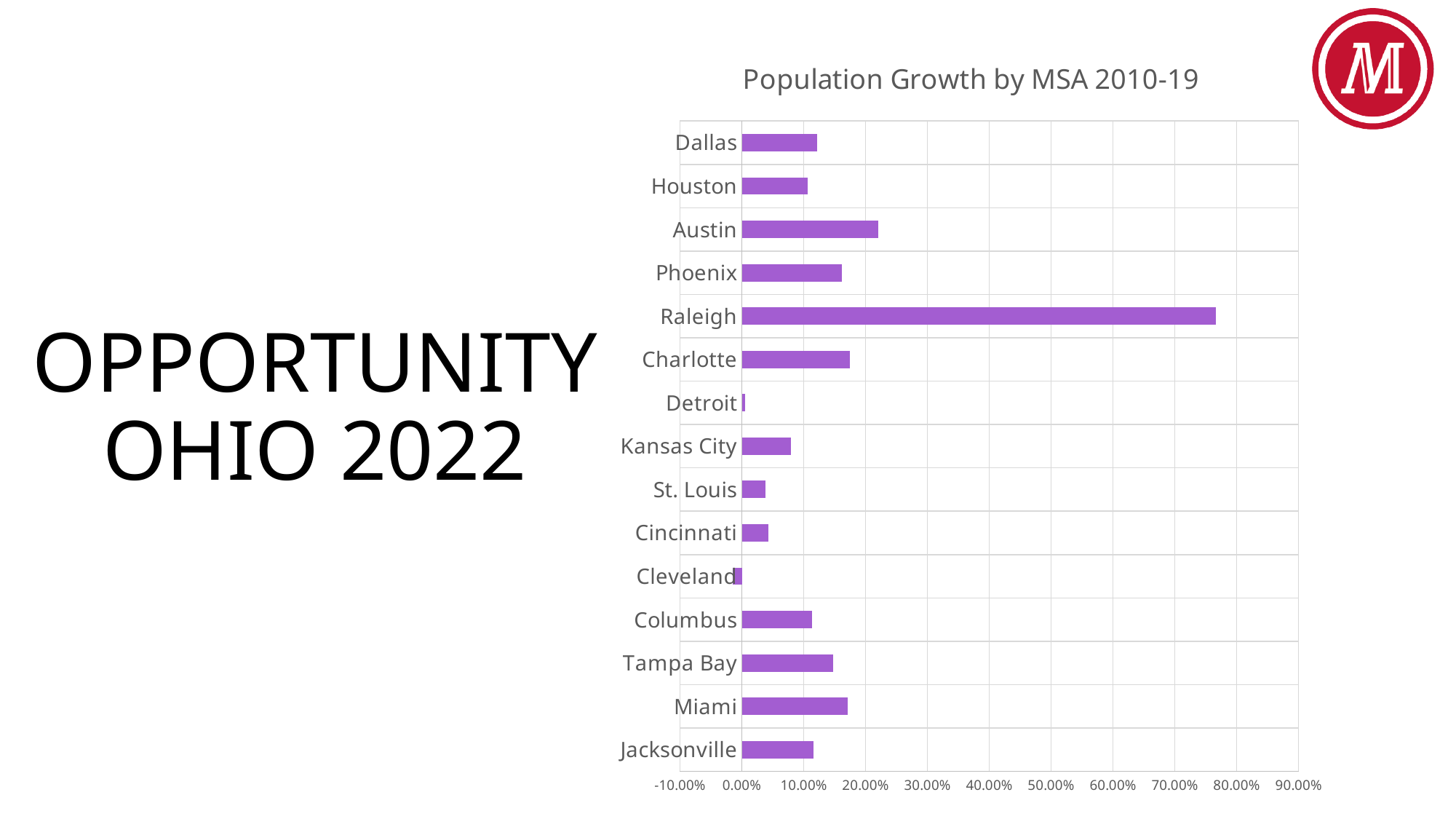
How many metropolitan areas (categories) are plotted in the chart? 15 What type of chart is shown on the slide? Bar chart Is the value for Raleigh greater or less than 70.00%? greater Is the value for Phoenix greater or less than 20.00%? less Is the value for Kansas City greater or less than 10.00%? less Which MSA has the lowest population growth in the chart? Cleveland Which has higher population growth, Detroit or Cleveland? Detroit Which has higher population growth, Kansas City or St. Louis? Kansas City What is the title of the chart? Population Growth by MSA 2010-19 Which MSA has the highest population growth in the chart? Raleigh Which has higher population growth, Austin or Phoenix? Austin